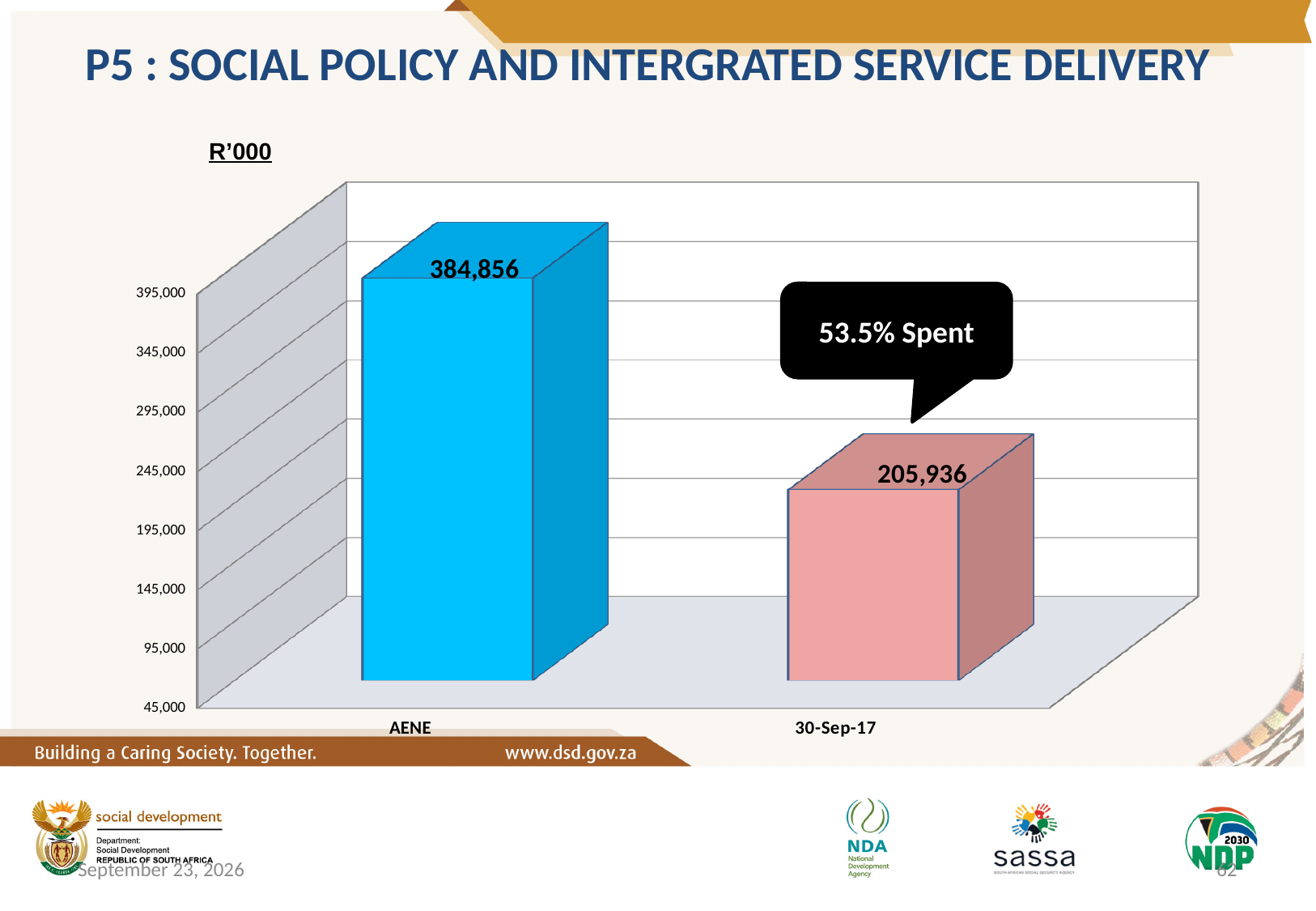
Which category has the highest value? AENE What is the value for 30-Sep-17? 205,936 What percentage spent is shown in the callout on the chart? 53.5% Spent How many categories are shown on the x axis? 2 Which category has the lowest value? 30-Sep-17 Is the value for AENE greater or less than 345,000? greater What is the difference between the AENE value and the 30-Sep-17 value? 178,920 What is the value for AENE? 384,856 Is the value for 30-Sep-17 greater or less than 245,000? less What kind of chart is shown on the slide? bar chart What unit label is shown above the chart? R'000 Which is larger, the value for AENE or the value for 30-Sep-17? AENE